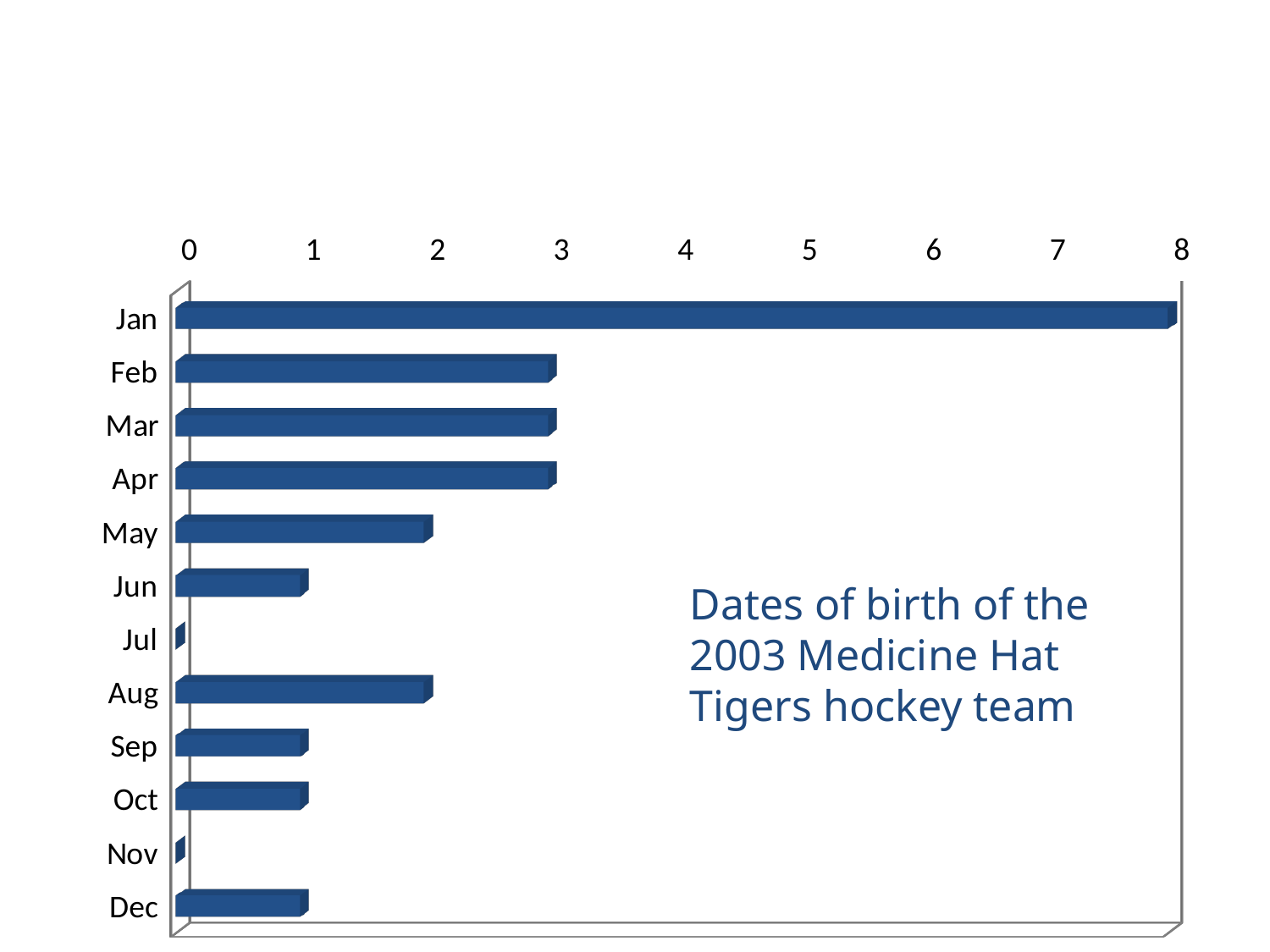
What kind of chart is shown on the slide? bar chart What is the value for Jan? 8 What is the value for May? 2 Is the value for Jan greater or less than 5? greater Which is larger, the value for Aug or the value for Sep? Aug What is the title text shown on the chart? Dates of birth of the 2003 Medicine Hat Tigers hockey team What is the difference between the values for Jan and Feb? 5 Which month has the highest value on the chart? Jan What is the value for Feb? 3 Is the value for Apr greater or less than 4? less How many months (categories) are plotted on the chart? 12 What is the value for Jun? 1